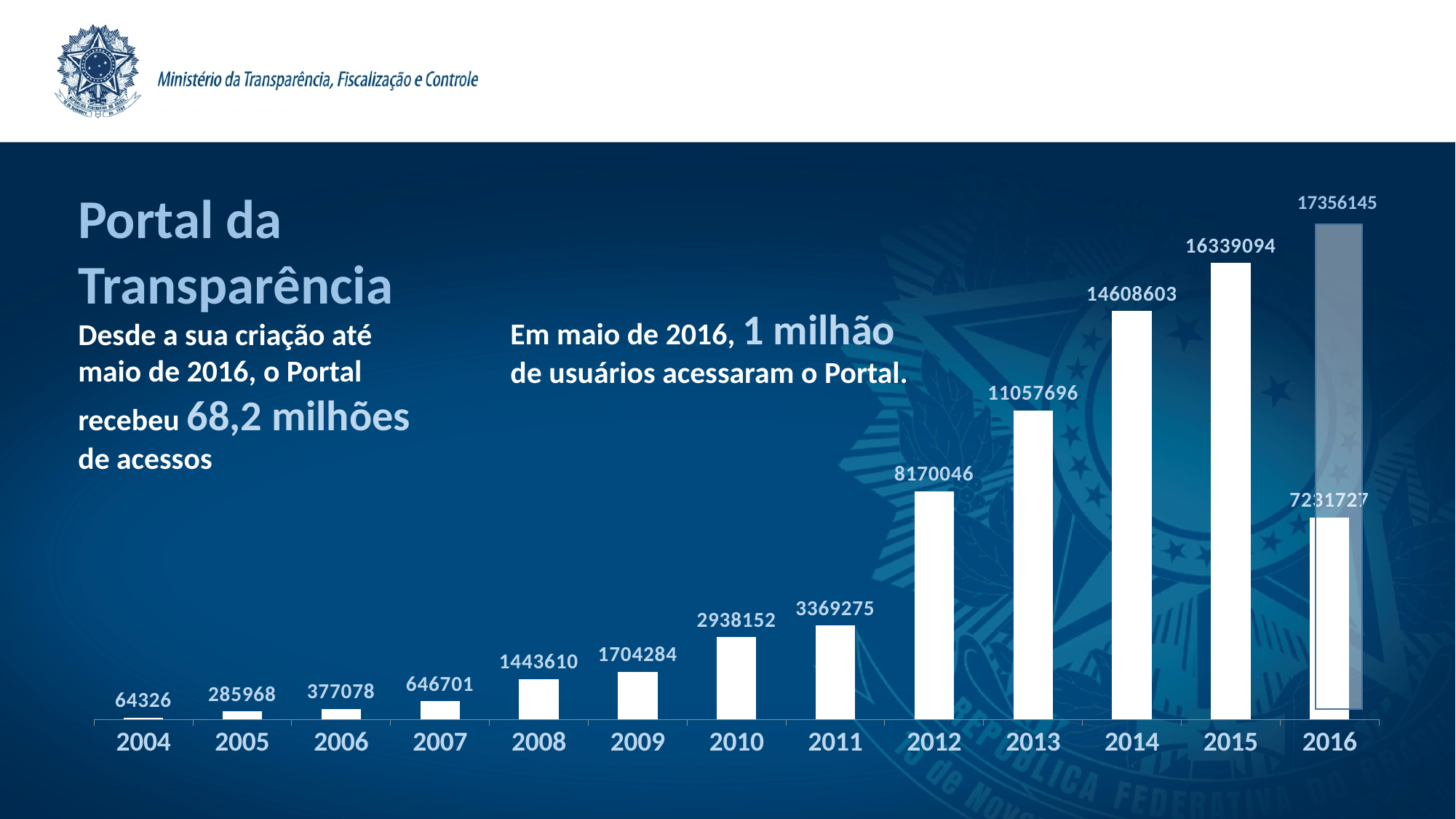
How many years are shown on the x axis? 13 What is the difference between the values for 2013 and 2012? 2887650 What is the title of the slide containing the chart? Portal da Transparência Do the values rise or fall from 2004 to 2015? rise What is the difference between the values for 2015 and 2014? 1730491 What kind of chart is shown on the slide? bar chart What is the value for 2015? 16339094 What is the value for 2004? 64326 Which is larger, the value for 2010 or the value for 2011? 2011 What is the value for 2008? 1443610 Which year has the lowest value? 2004 What is the value for 2012? 8170046